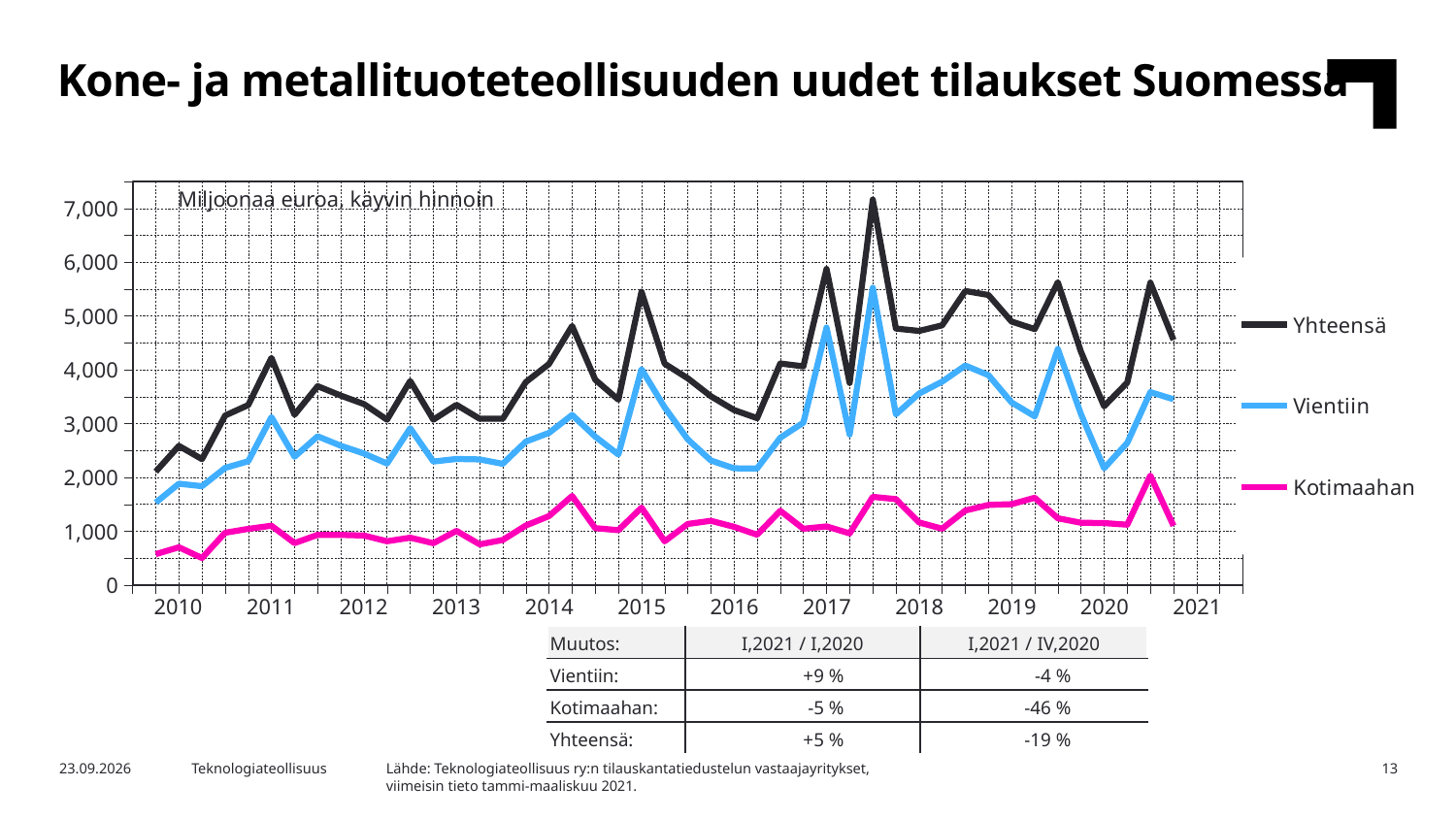
What kind of chart is shown on the slide? line chart How many year labels are shown on the x axis? 12 Is the peak value of the Yhteensä series in 2017 greater or less than 6,000? greater Does the Yhteensä series rise or fall from the start of 2010 to the start of 2011? rise Which series is larger in 2019, Vientiin or Kotimaahan? Vientiin Is the value for Kotimaahan at the start of 2010 greater or less than 1,000? less Which series has the highest values throughout the chart? Yhteensä Which series has the lowest values throughout the chart? Kotimaahan Is the peak value of the Vientiin series in 2017 greater or less than 5,000? greater What unit is stated at the top of the chart area? Miljoonaa euroa, käyvin hinnoin Which series is shown in black in the legend? Yhteensä How many series does the legend list? 3